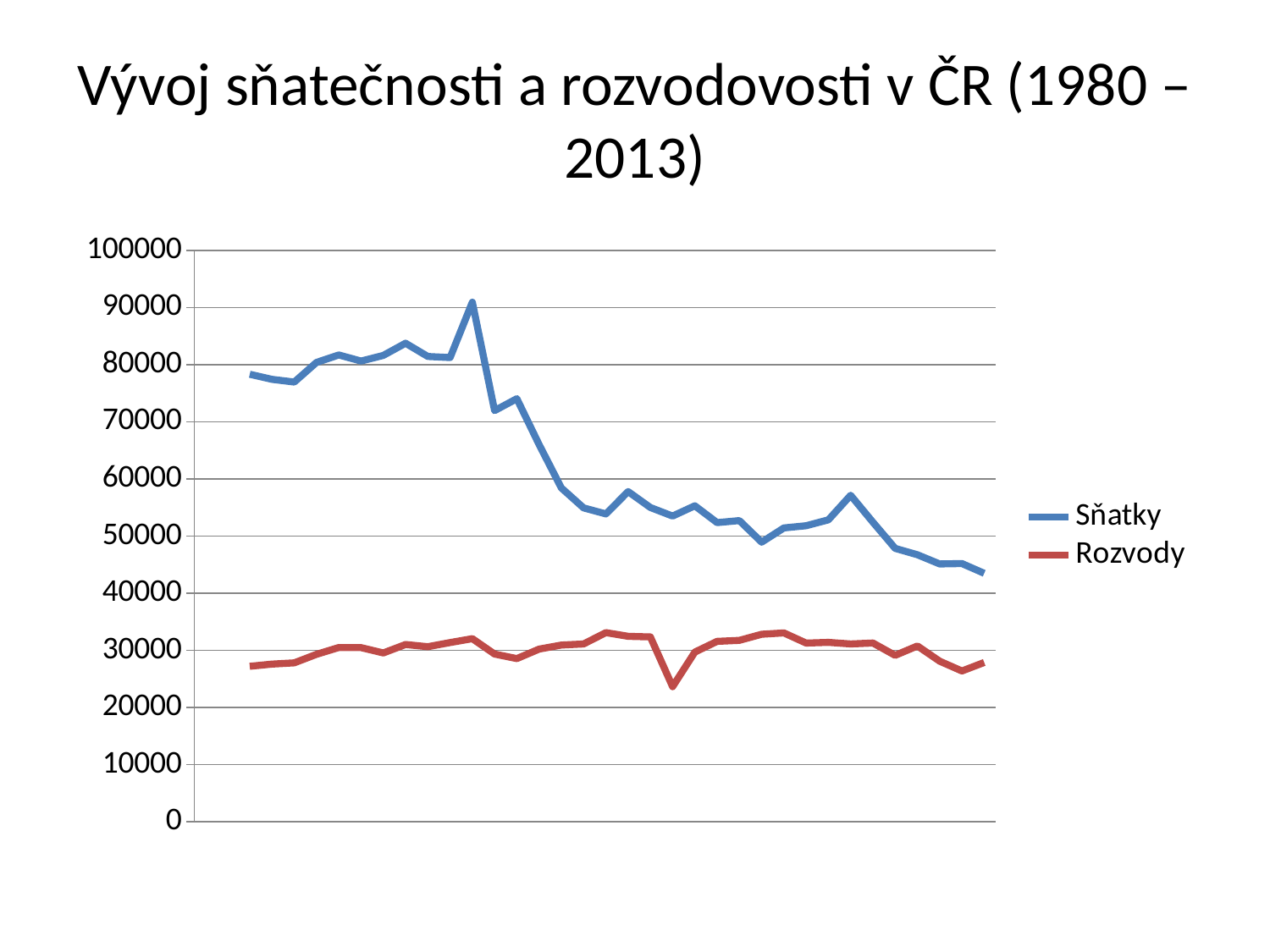
Is the highest point of the Rozvody series greater or less than 40000? less What are the two series named in the legend? Sňatky and Rozvody What is the title of the slide? Vývoj sňatečnosti a rozvodovosti v ČR (1980 – 2013) Is the lowest point of the Rozvody series greater or less than 30000? less How many series does the legend list? 2 Is the highest point of the Sňatky series greater or less than 80000? greater What kind of chart is shown on the slide? line chart Which series has higher values throughout the chart, Sňatky or Rozvody? Sňatky Does the Sňatky series overall rise or fall from left to right? fall Which series contains the lowest point plotted on the chart? Rozvody